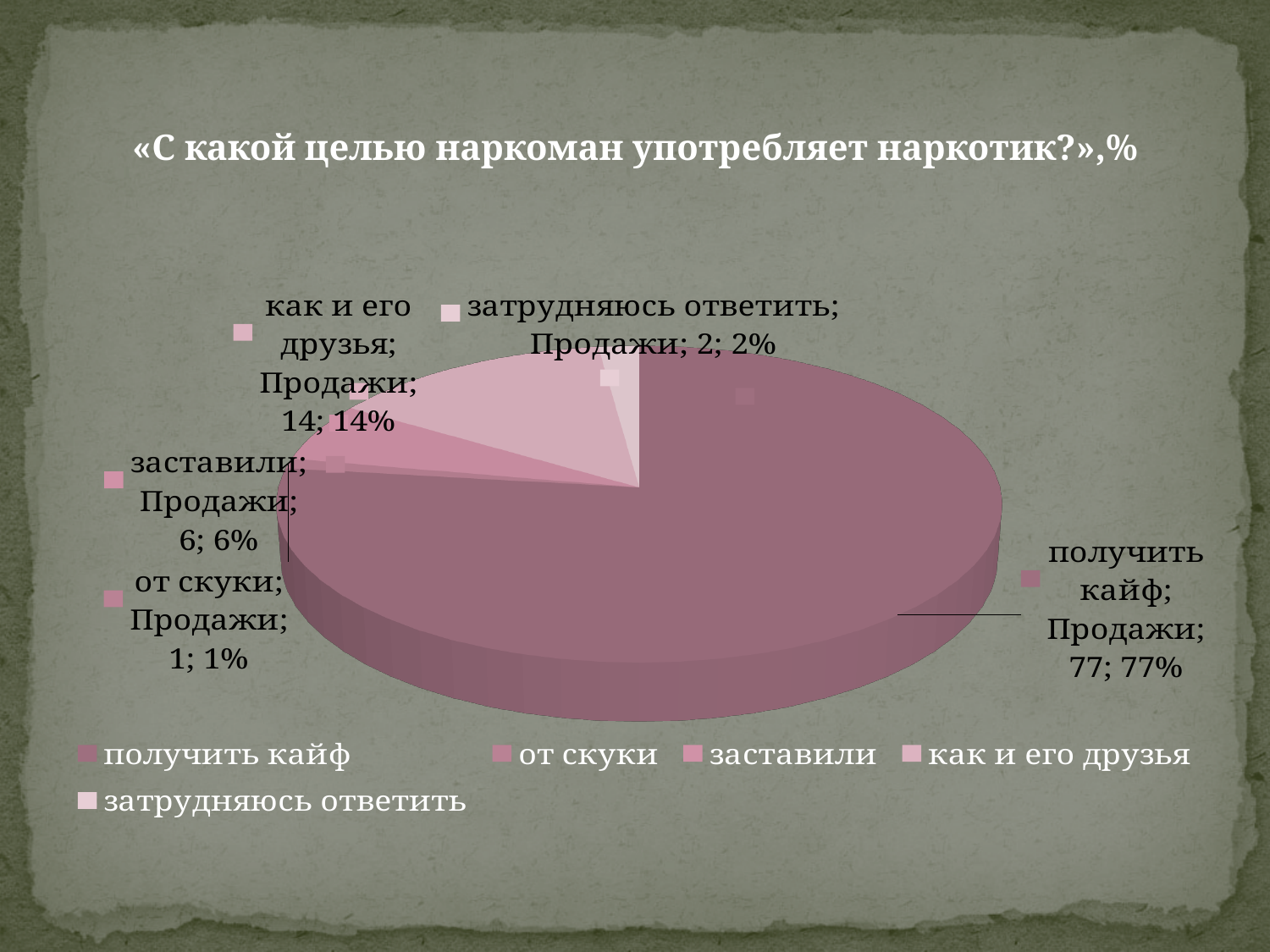
What share of the pie does «как и его друзья» represent? 14% What is the value for «затрудняюсь ответить»? 2 What is the value for «получить кайф»? 77 Which is larger, the value for «заставили» or the value for «затрудняюсь ответить»? заставили What is the difference between the values for «получить кайф» and «как и его друзья»? 63 How many categories does the pie chart have? 5 Which category has the smallest slice of the pie? от скуки What is the title of the chart? «С какой целью наркоман употребляет наркотик?»,% What is the value for «заставили»? 6 Which category has the largest slice of the pie? получить кайф What is the value for «как и его друзья»? 14 What kind of chart is shown on the slide? pie chart